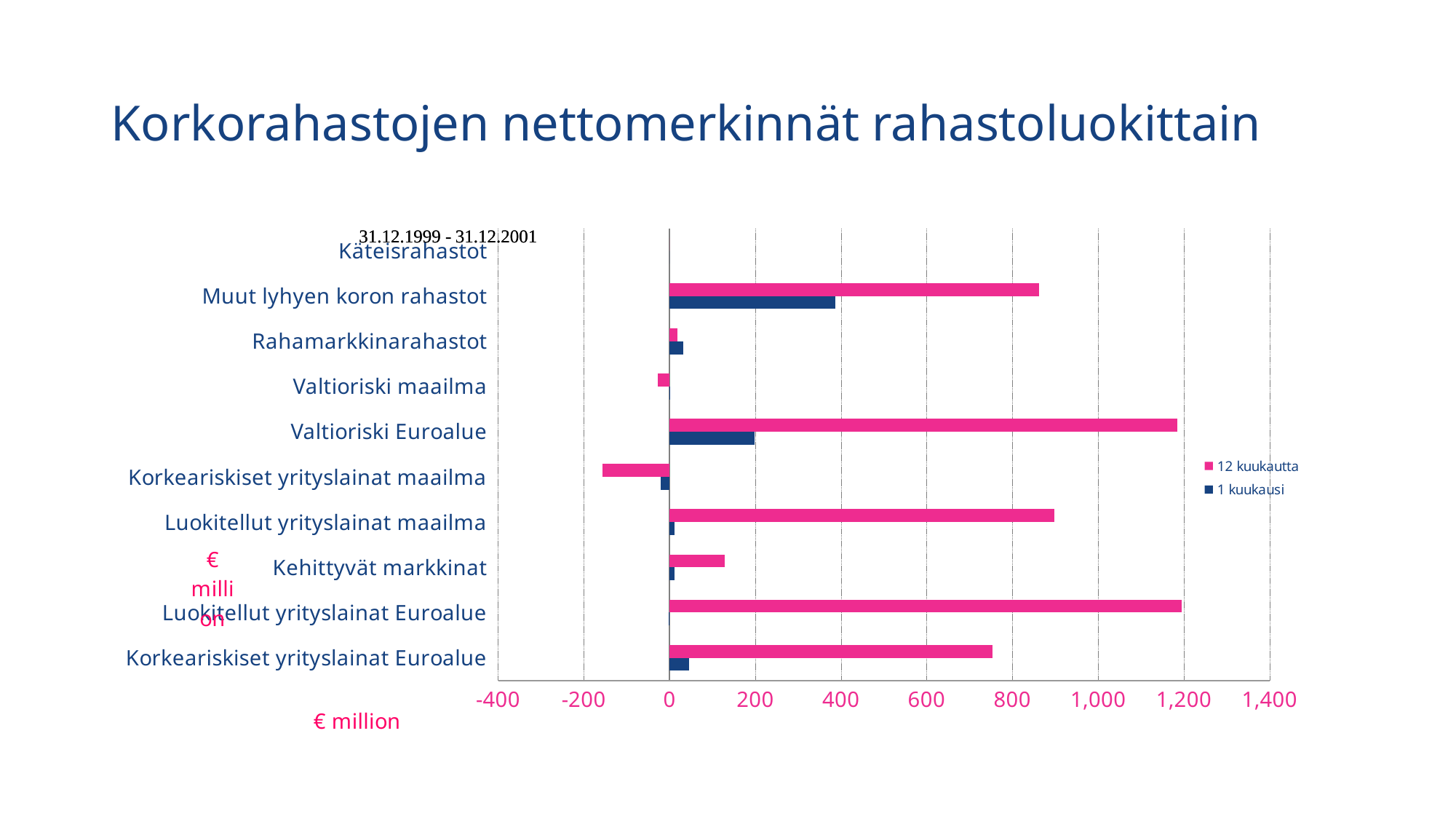
For the 12 kuukautta series, which is larger: Muut lyhyen koron rahastot or Korkeariskiset yrityslainat Euroalue? Muut lyhyen koron rahastot Which category has the highest value for the 1 kuukausi series? Muut lyhyen koron rahastot Which category has the lowest value for the 12 kuukautta series? Korkeariskiset yrityslainat maailma Is the 12 kuukautta value for Valtioriski Euroalue greater or less than 1,000? greater Is the 12 kuukautta value for Kehittyvät markkinat greater or less than 200? less How many series does the legend list? 2 Is the 12 kuukautta value for Korkeariskiset yrityslainat maailma greater or less than -100? less How many fund categories are listed on the vertical axis? 10 What kind of chart is shown on the slide? bar chart What unit is shown on the horizontal axis? € million